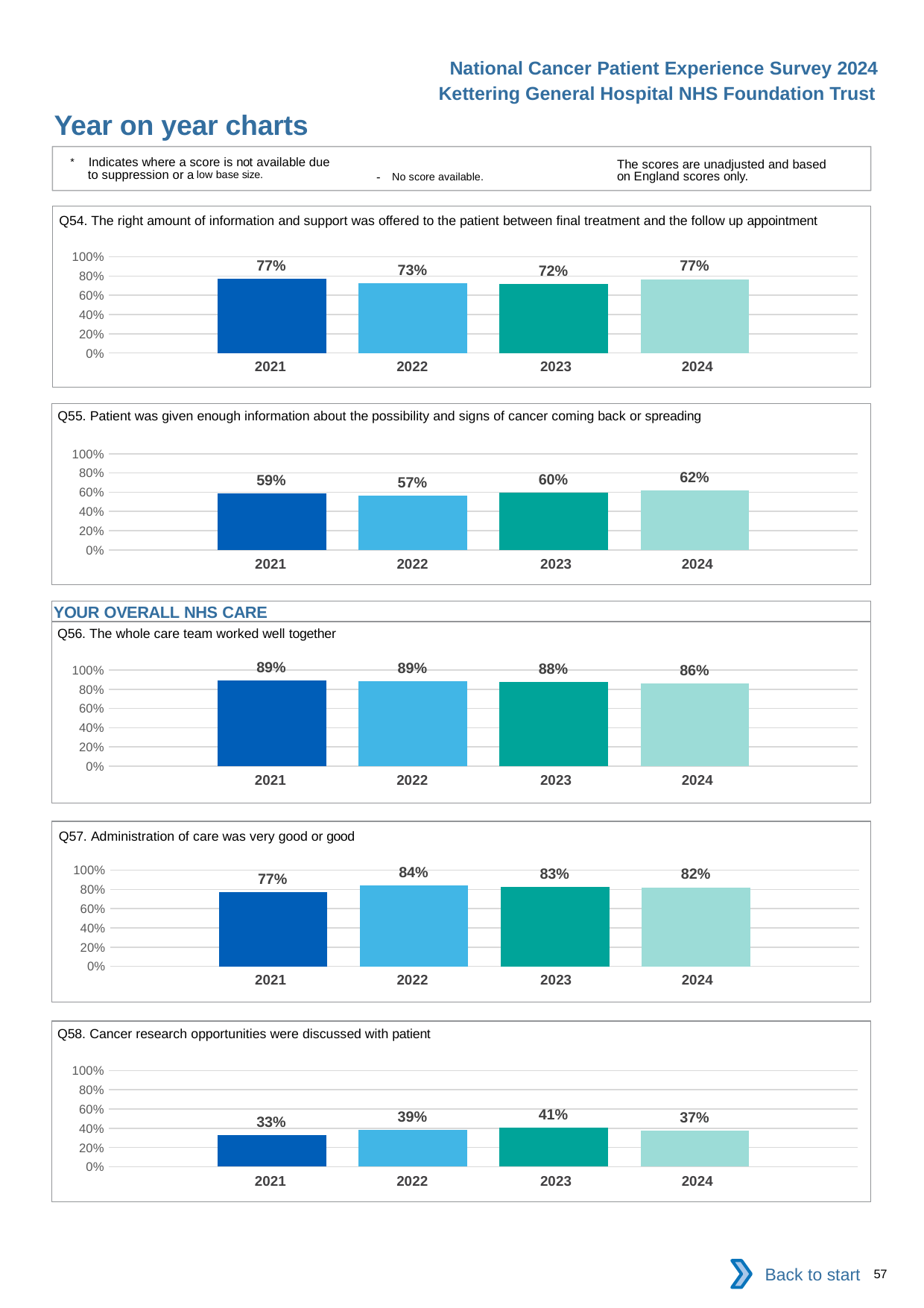
How many years are shown in the Q54 chart? 4 What kind of chart is the Q57 chart? bar chart In the Q56 chart, do the values rise or fall from 2022 to 2024? fall In the Q58 chart, is the value for 2021 greater or less than 40%? less In the Q58 chart, which year has the highest value? 2023 How many charts are shown on the slide? 5 In the Q55 chart, which year has the lowest value? 2022 In the Q54 chart, what is the value for 2022? 73% In the Q55 chart, which year has the highest value? 2024 In the Q57 chart, what is the difference between the 2022 value and the 2021 value? 7% In the Q56 chart, what is the value for 2024? 86% In the Q58 chart, is the value for 2021 larger or smaller than the value for 2024? smaller